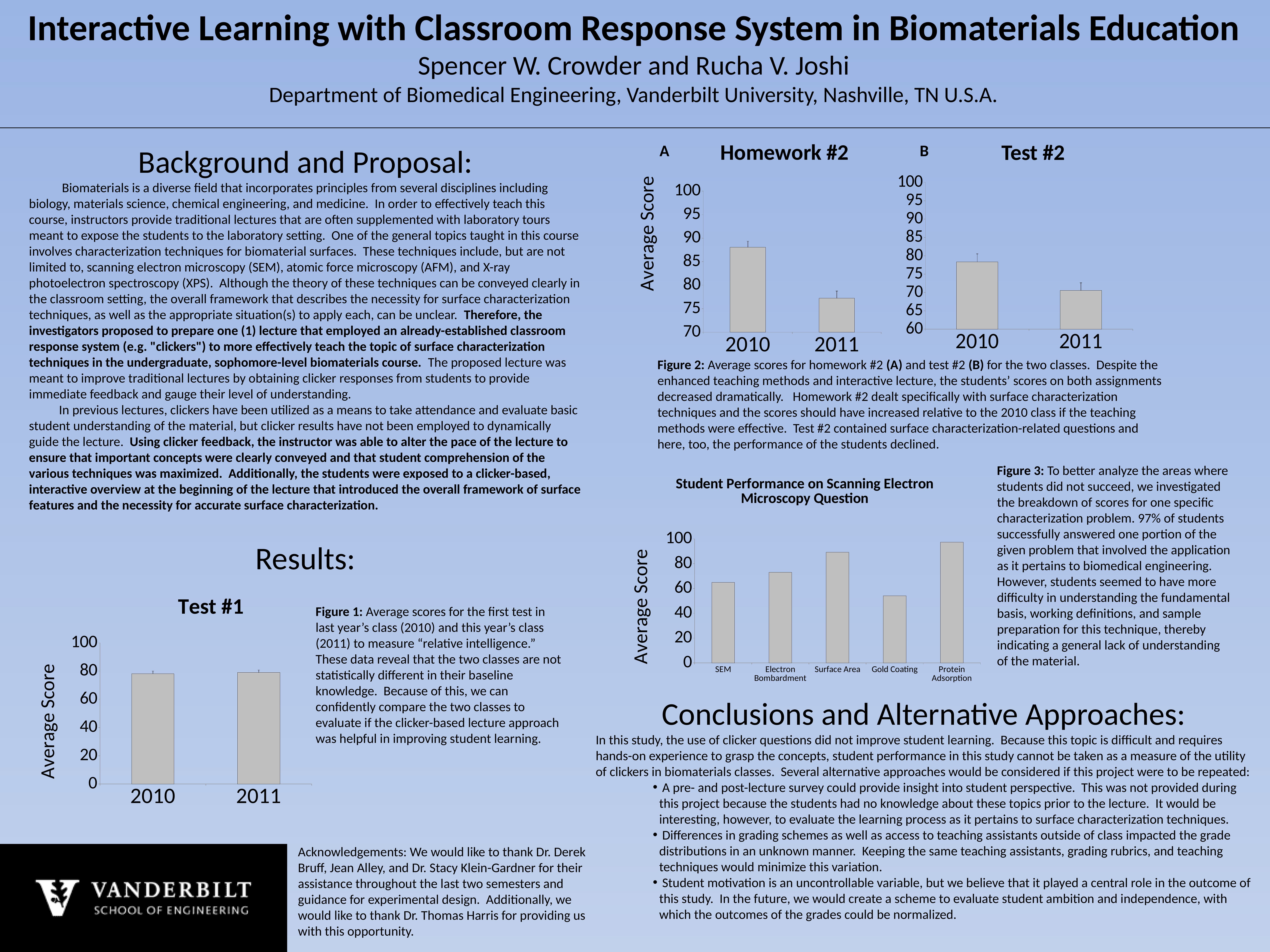
What kind of chart is the Test #1 chart? bar chart In the Homework #2 chart, is the value for 2010 greater or less than 85? greater In the Student Performance on Scanning Electron Microscopy Question chart, which category has the highest average score? Protein Adsorption In the Test #1 chart, is the value for 2010 greater or less than 60? greater In the Student Performance on Scanning Electron Microscopy Question chart, is the value for Surface Area greater or less than 80? greater In the Student Performance on Scanning Electron Microscopy Question chart, how many categories are shown? 5 In the Student Performance on Scanning Electron Microscopy Question chart, which category has the lowest average score? Gold Coating In the Test #2 chart, do the average scores rise or fall from 2010 to 2011? fall In the Test #1 chart, how many years are plotted? 2 In the Homework #2 chart, which year has the higher average score, 2010 or 2011? 2010